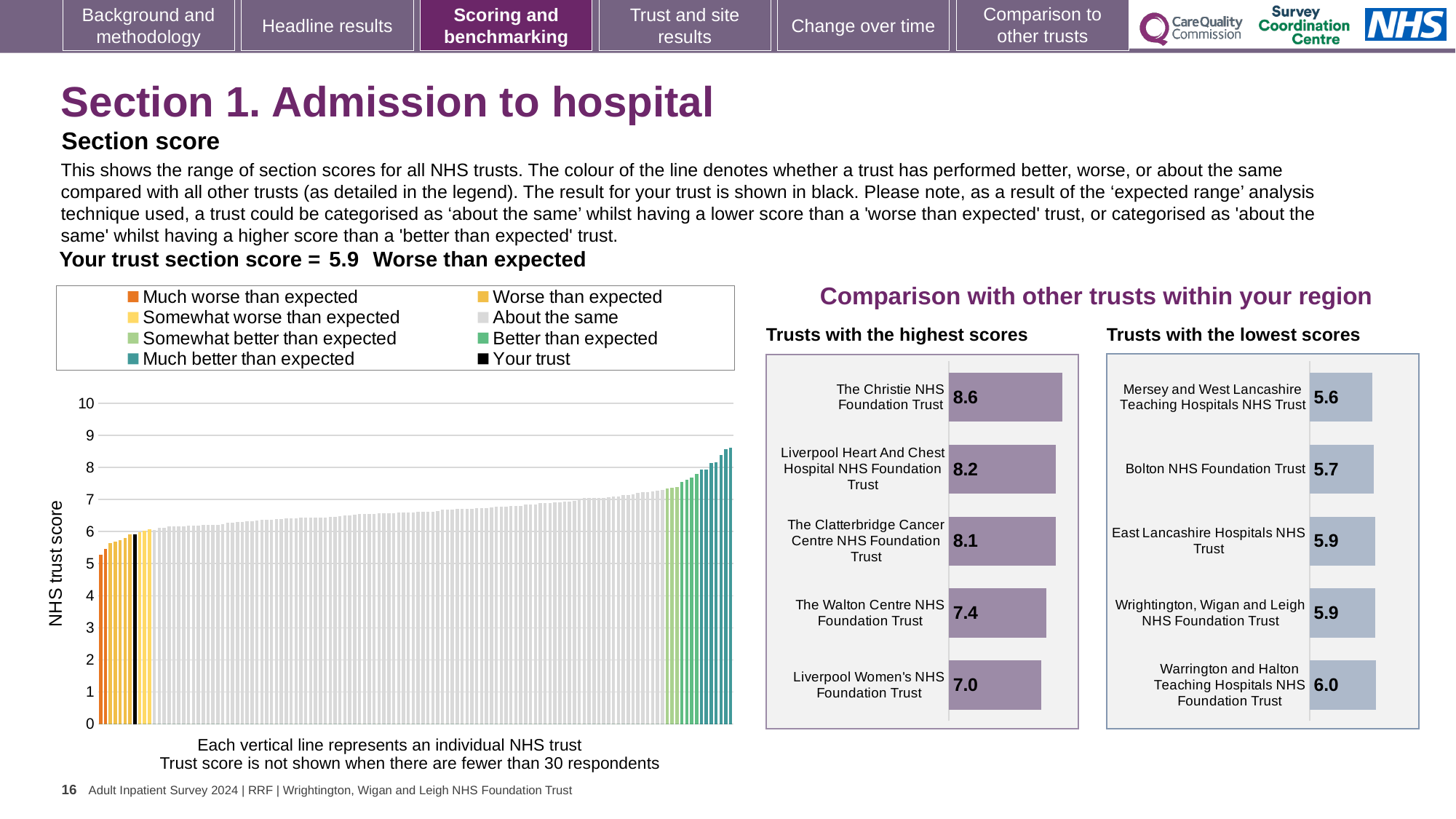
In the NHS trust score chart on the left, do the values rise or fall from left to right? Rise In the 'Trusts with the highest scores' chart, what is the difference between the scores of The Christie NHS Foundation Trust and Liverpool Women's NHS Foundation Trust? 1.6 In the 'Trusts with the highest scores' chart, what is the score for The Christie NHS Foundation Trust? 8.6 In the 'Trusts with the highest scores' chart, which trust has the lowest score? Liverpool Women's NHS Foundation Trust How many entries does the legend of the NHS trust score chart on the left list? 8 In the 'Trusts with the lowest scores' chart, what is the score for Bolton NHS Foundation Trust? 5.7 How many trusts are shown in the 'Trusts with the lowest scores' chart? 5 In the 'Trusts with the highest scores' chart, what is the score for The Walton Centre NHS Foundation Trust? 7.4 In the 'Trusts with the lowest scores' chart, which trust has the lowest score? Mersey and West Lancashire Teaching Hospitals NHS Trust In the 'Trusts with the lowest scores' chart, what is the difference between the scores of Warrington and Halton Teaching Hospitals NHS Foundation Trust and Mersey and West Lancashire Teaching Hospitals NHS Trust? 0.4 What kind of chart is the NHS trust score chart on the left of the slide? Bar chart In the 'Trusts with the highest scores' chart, which has the higher score: Liverpool Heart And Chest Hospital NHS Foundation Trust or The Clatterbridge Cancer Centre NHS Foundation Trust? Liverpool Heart And Chest Hospital NHS Foundation Trust